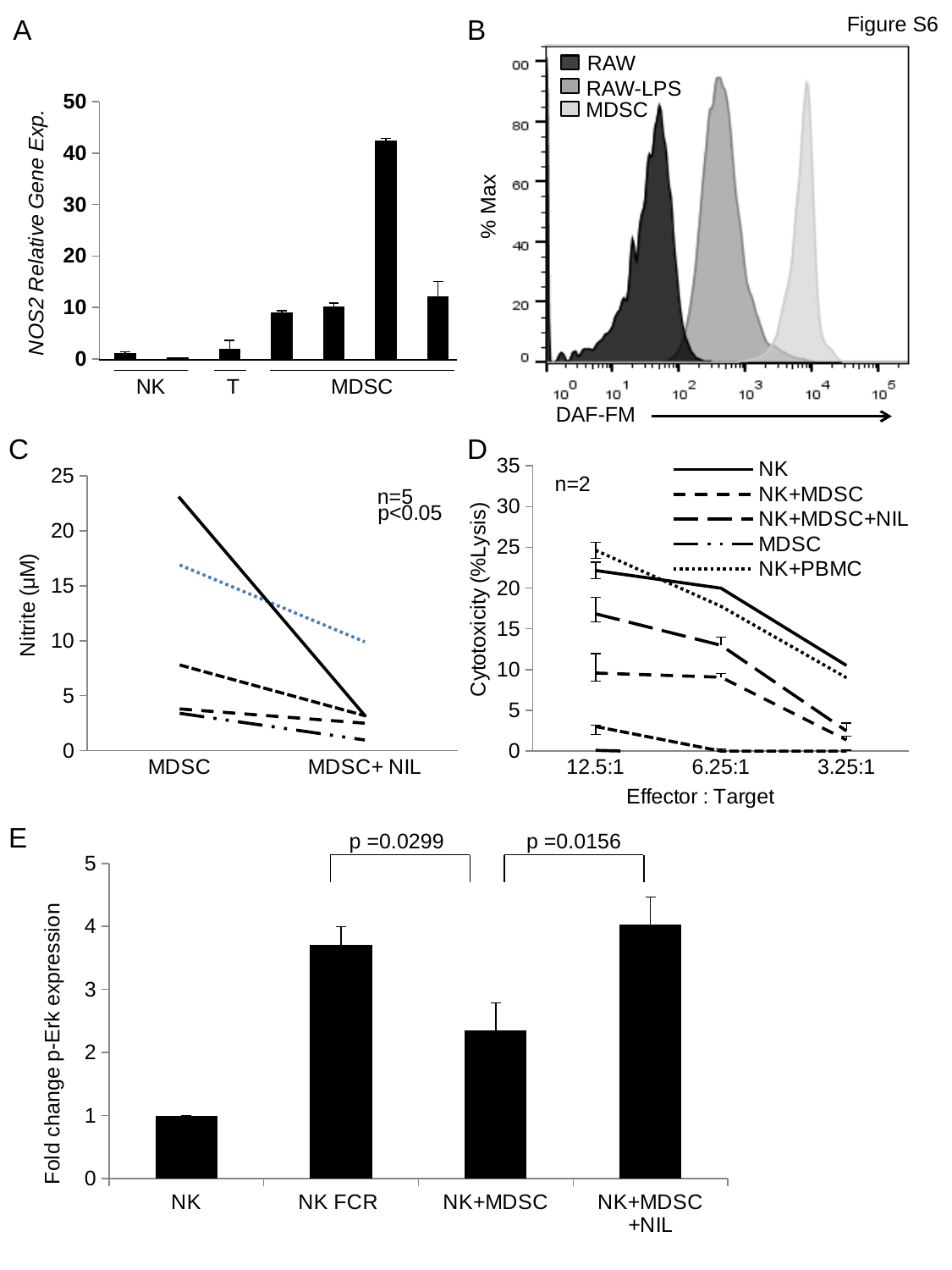
In panel B, which population's peak lies furthest to the right along the DAF-FM axis? MDSC In panel A, which group contains the tallest bar: NK, T or MDSC? MDSC In panel A, how many bars are plotted in total? 7 In panel E, is the value for NK+MDSC greater or less than 2? greater In panel C, does the solid black line rise or fall from MDSC to MDSC+ NIL? fall How many populations does the legend in panel B list? 3 In panel E, which category has the lowest fold change p-Erk expression? NK In panel D, is the NK value at 3.25:1 greater or less than 15? less What kind of chart is panel A? bar chart In panel A, is the tallest MDSC bar greater or less than 40? greater How many series does the legend in panel D list? 5